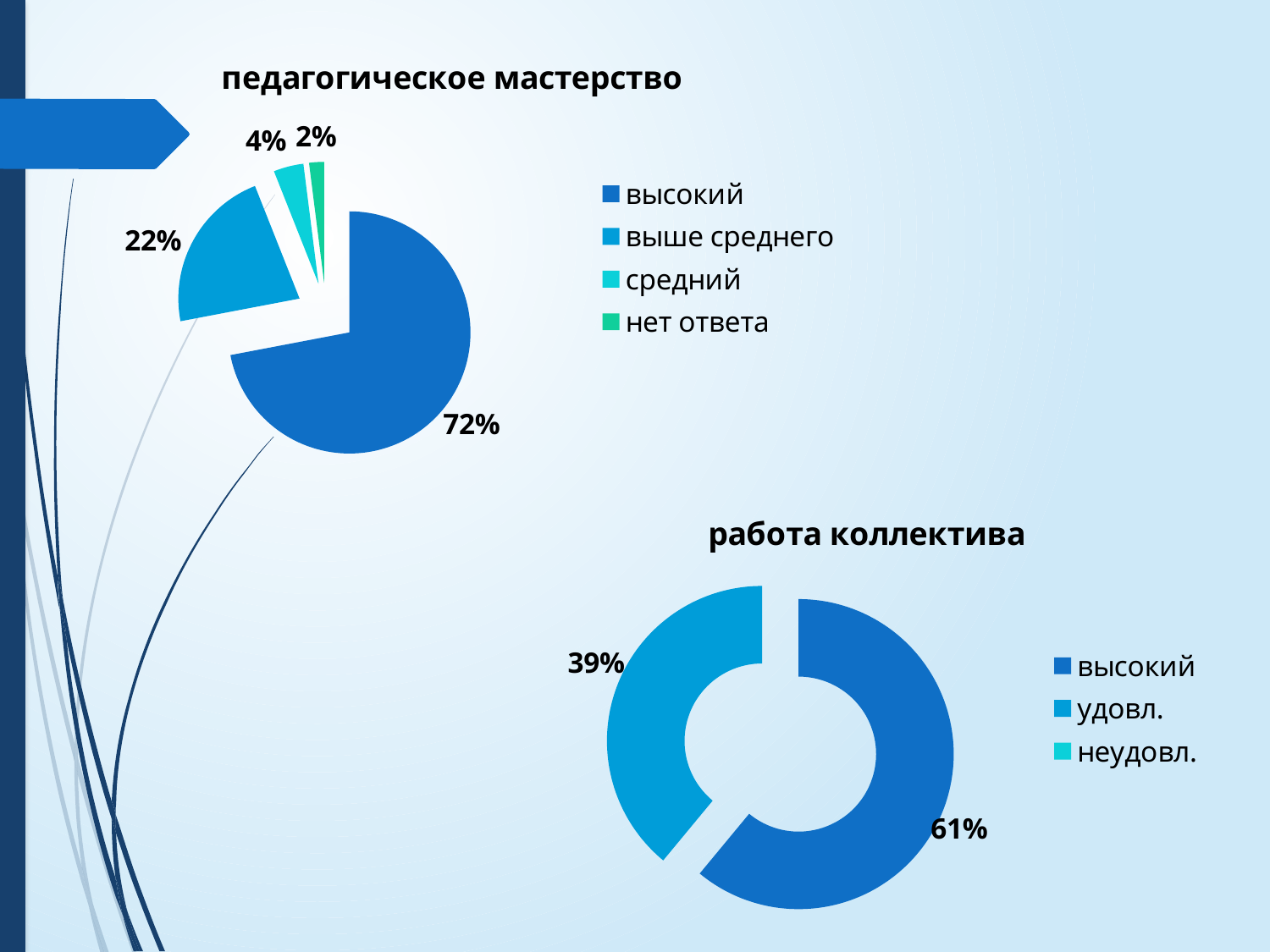
In the 'педагогическое мастерство' chart, what share is labelled for 'средний'? 4% In the 'педагогическое мастерство' chart, which category has the largest slice? высокий What kind of chart is 'работа коллектива'? doughnut chart How many entries does the legend of the 'работа коллектива' chart list? 3 In the 'педагогическое мастерство' chart, what share is labelled for 'высокий'? 72% In the 'педагогическое мастерство' chart, which category has the smallest slice? нет ответа In the 'работа коллектива' chart, which is larger: 'высокий' or 'удовл.'? высокий In the 'педагогическое мастерство' chart, what share is labelled for 'выше среднего'? 22% In the 'работа коллектива' chart, what share is labelled for 'удовл.'? 39% How many entries does the legend of the 'педагогическое мастерство' chart list? 4 In the 'педагогическое мастерство' chart, what is the difference between the 'высокий' and 'выше среднего' shares? 50% In the 'работа коллектива' chart, what share is labelled for 'высокий'? 61%